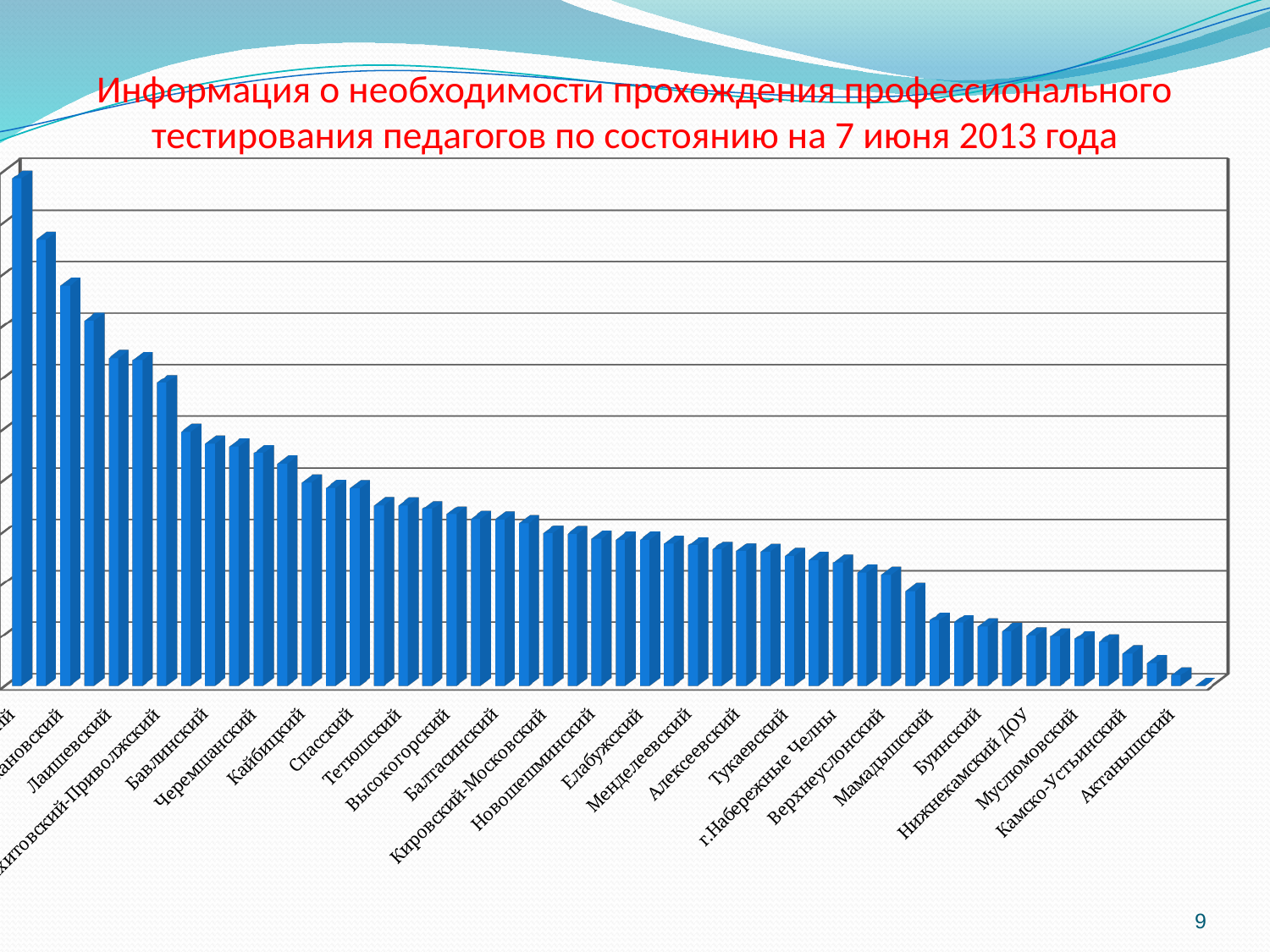
Do the values rise or fall moving from left to right along the x axis? fall Which has the larger value, Бавлинский or Буинский? Бавлинский Which has the larger value, Спасский or Муслюмовский? Спасский What is the title of the chart on the slide? Информация о необходимости прохождения профессионального тестирования педагогов по состоянию на 7 июня 2013 года Which has the larger value, Кайбицкий or Тукаевский? Кайбицкий What colour are the bars in the chart? blue What kind of chart is shown on the slide? bar chart